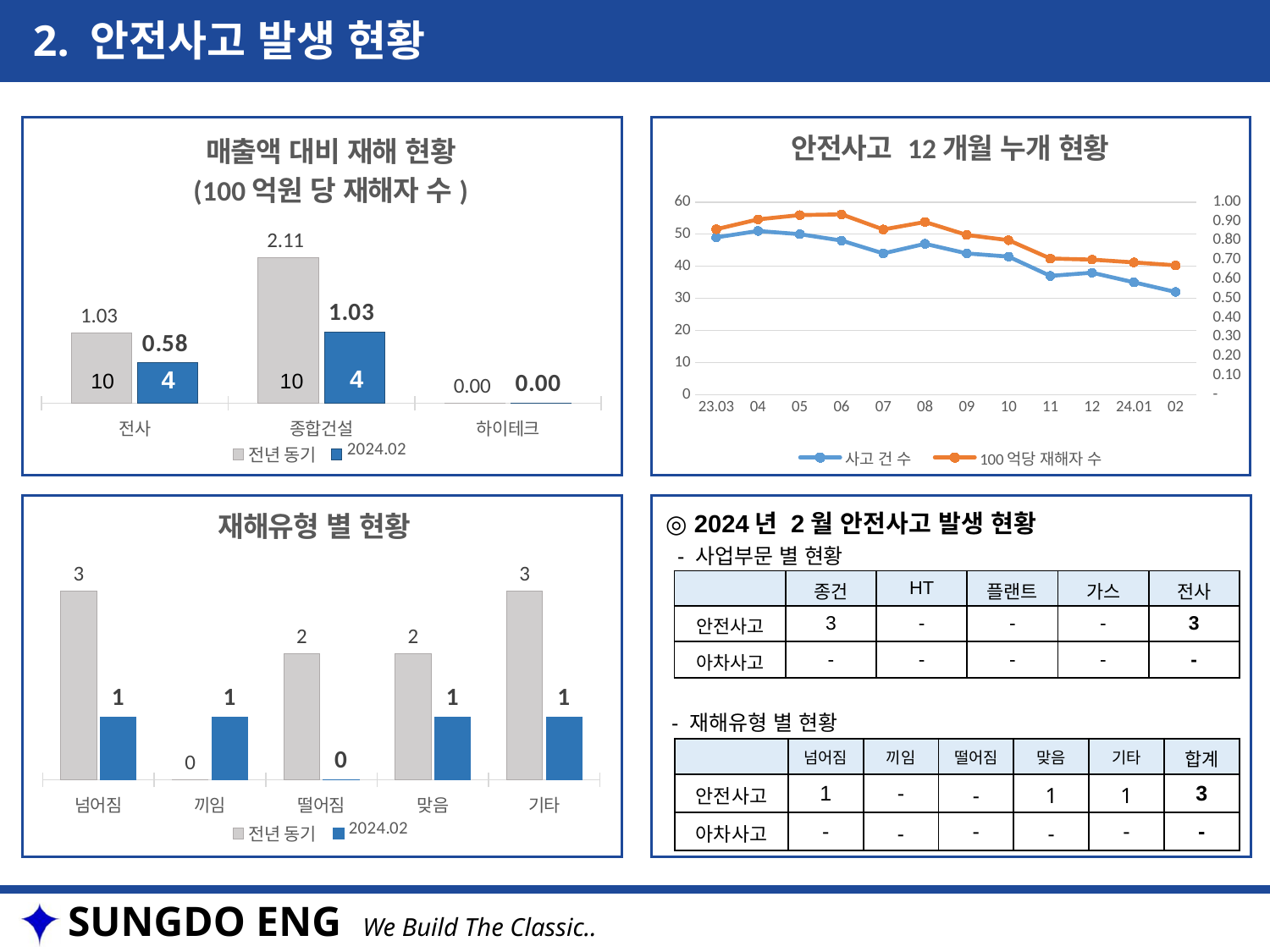
In the chart titled 매출액 대비 재해 현황, which category has the highest 전년 동기 value? 종합건설 In the chart titled 매출액 대비 재해 현황, how many series does the legend list? 2 In the chart titled 매출액 대비 재해 현황, what is the 전년 동기 value for 종합건설? 2.11 What kind of chart is the chart titled 안전사고 12개월 누개 현황? line chart In the chart titled 안전사고 12개월 누개 현황, is the 사고 건 수 value at 02 greater or less than 40? less In the chart titled 재해유형 별 현황, which category has the lowest 2024.02 value? 떨어짐 In the chart titled 재해유형 별 현황, which is larger for 넘어짐: the 전년 동기 value or the 2024.02 value? 전년 동기 In the chart titled 매출액 대비 재해 현황, what is the 2024.02 value for 전사? 0.58 In the chart titled 안전사고 12개월 누개 현황, how many points are plotted along the x axis for each series? 12 In the chart titled 재해유형 별 현황, what is the 전년 동기 value for 떨어짐? 2 In the chart titled 매출액 대비 재해 현황, what is the difference between the 전년 동기 and 2024.02 values for 종합건설? 1.08 In the chart titled 안전사고 12개월 누개 현황, does the 사고 건 수 series rise or fall from 23.03 to 02? fall